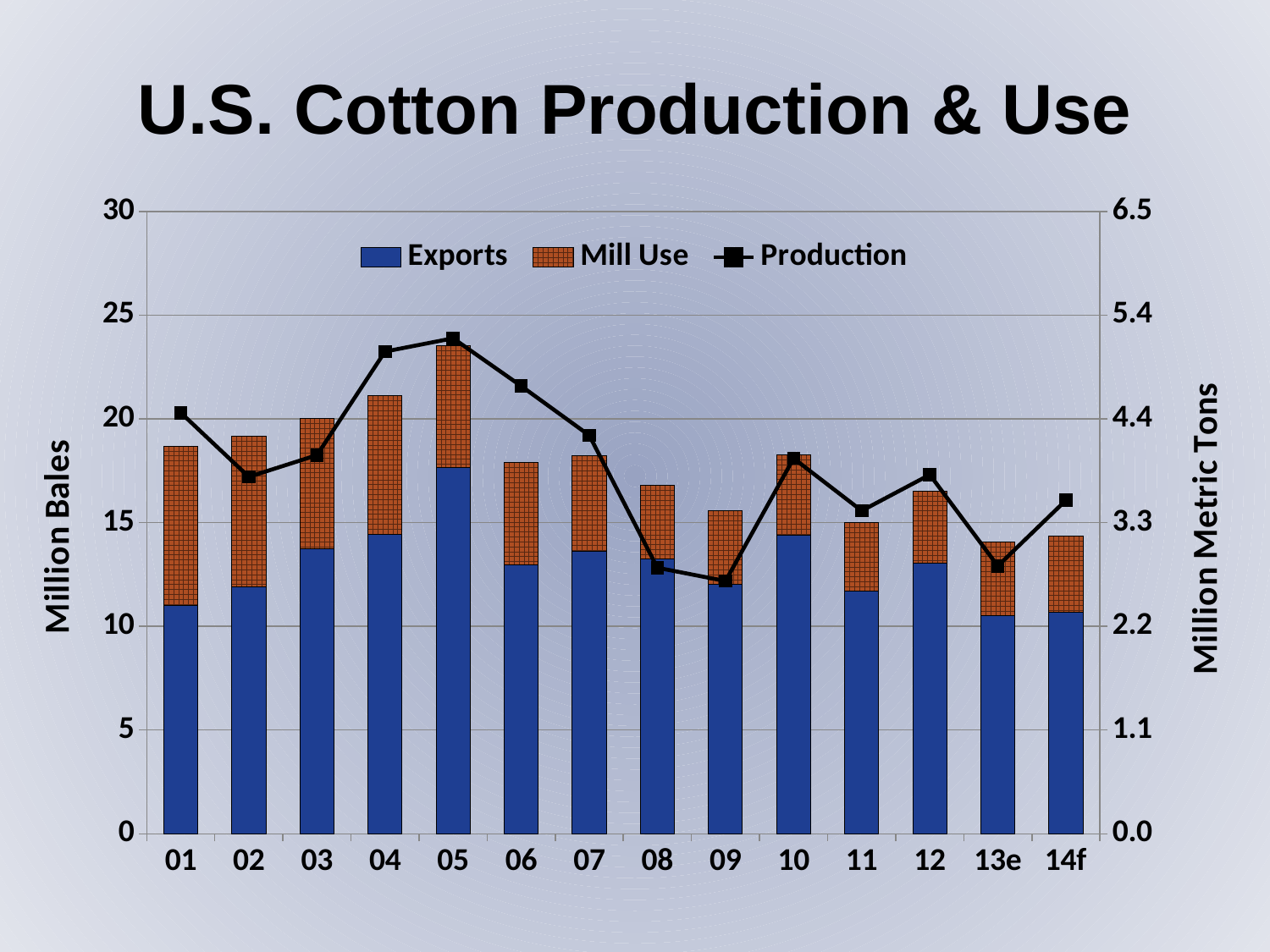
Is the Production value for 09 greater or less than 3.3 million metric tons? less Is the Exports value for 01 greater or less than 15 million bales? less In which year is the total stacked bar (Exports plus Mill Use) the highest? 05 Which year has the larger total stacked bar, 04 or 12? 04 Does the Production line rise or fall from 05 to 09? It falls Is the Exports value for 05 greater or less than 15 million bales? greater How many years (categories) are shown on the x axis? 14 In which year is the Exports bar the tallest? 05 How many series does the legend list? 3 What kind of chart is shown on the slide? A bar chart with a line (combination chart) In which year does the Production line reach its highest point? 05